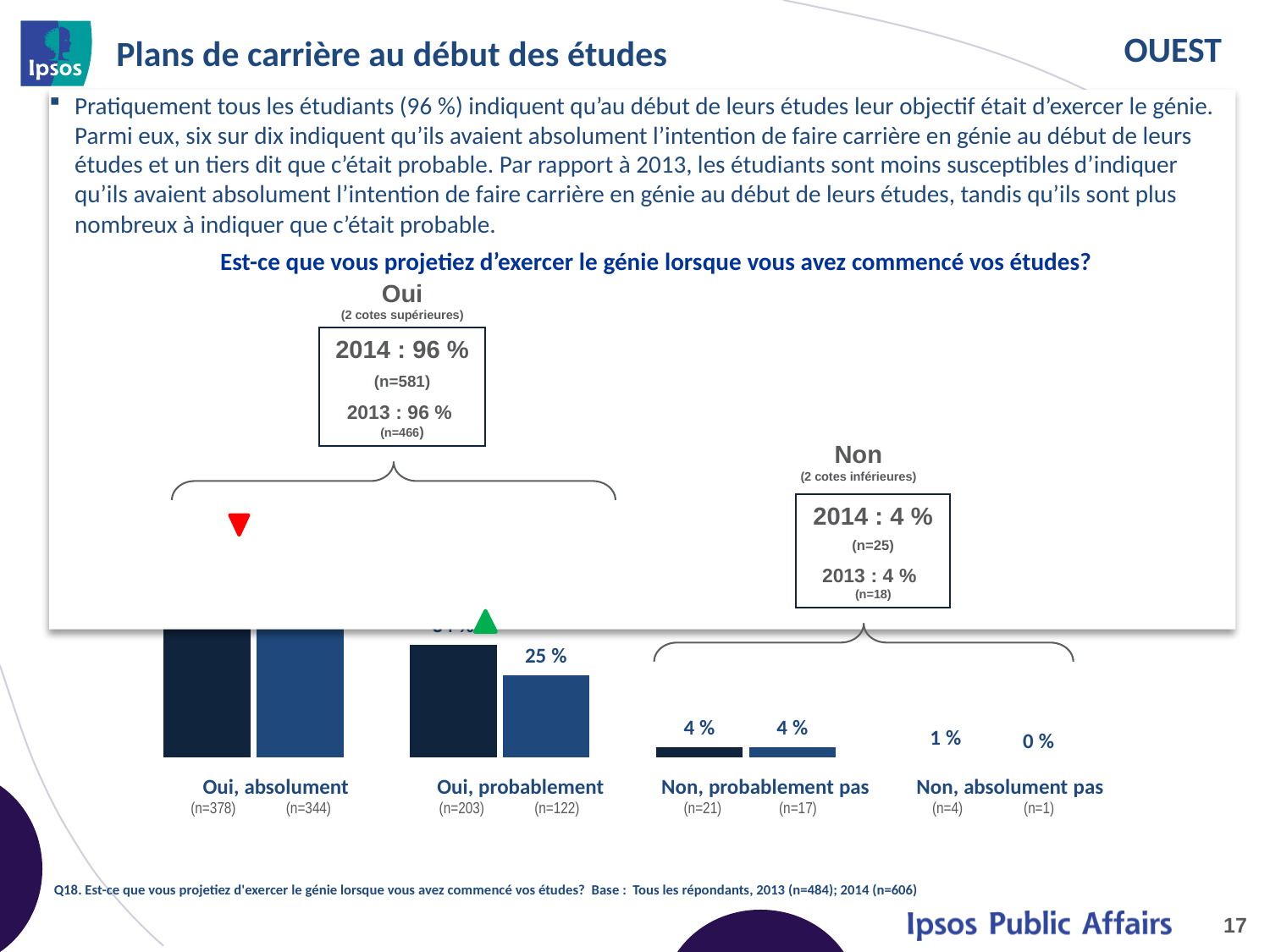
How many response categories are shown along the x axis of the chart? 4 What is the value of the first (dark navy) bar for "Non, absolument pas"? 1 % What is the title of the chart? Est-ce que vous projetiez d'exercer le génie lorsque vous avez commencé vos études? What is the difference between the lighter blue bars for "Oui, probablement" and "Non, probablement pas"? 21 % What is the value of the first (dark navy) bar for "Non, probablement pas"? 4 % What is the value of the second (lighter blue) bar for "Oui, probablement"? 25 % Which response category has the tallest bars? Oui, absolument Do the bar values rise or fall moving from left to right across the categories? fall What kind of chart is shown on the slide? bar chart Which response category has the lowest values? Non, absolument pas According to the "Oui (2 cotes supérieures)" box above the chart, what is the 2014 value? 96 % What is the value of the second (lighter blue) bar for "Non, absolument pas"? 0 %